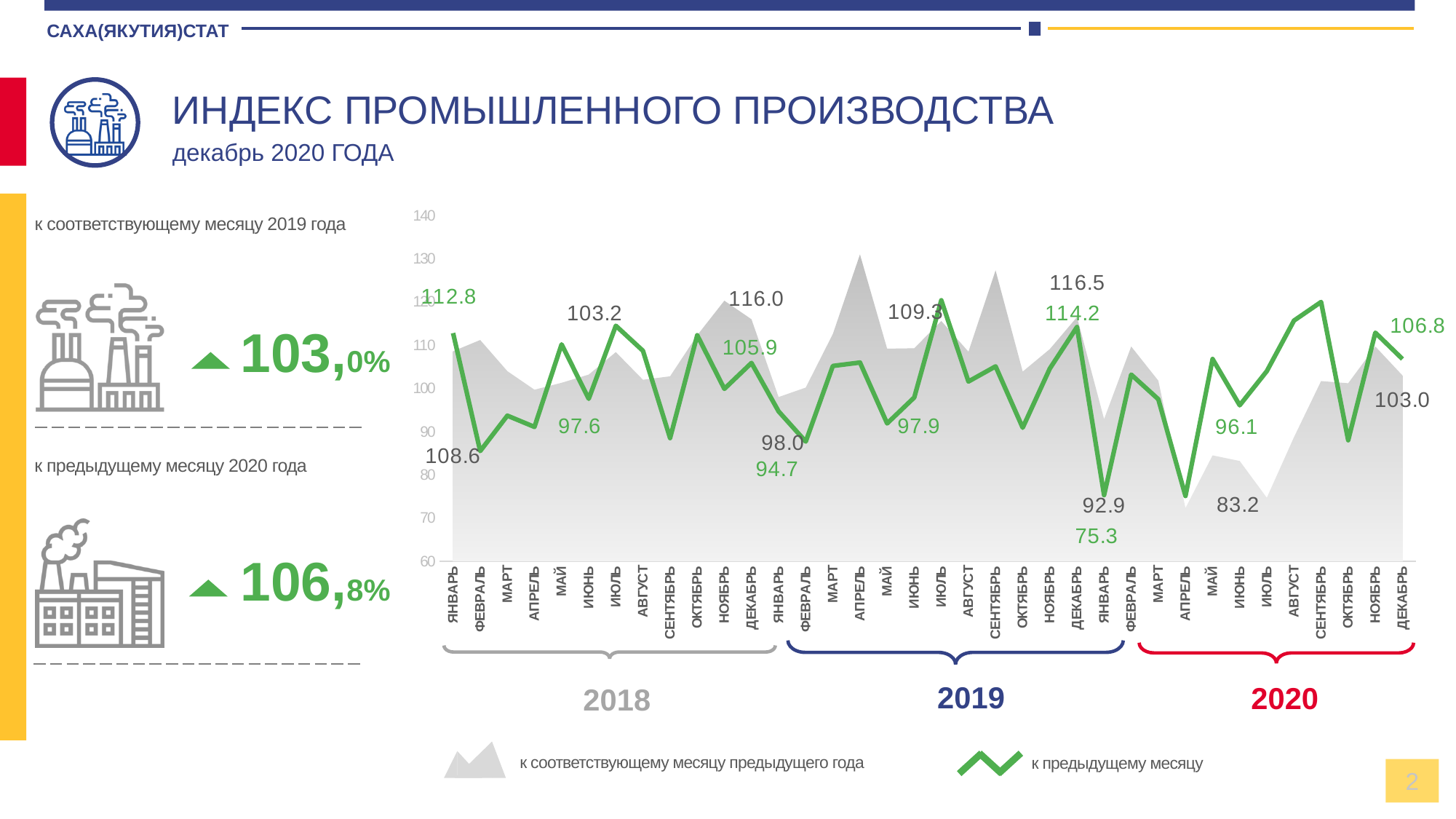
By how much does the green line value for ДЕКАБРЬ 2020 exceed its value for ЯНВАРЬ 2020? 31.5 What is the value of the green line (к предыдущему месяцу) for ДЕКАБРЬ 2020? 106.8 What does the legend say the green line represents? к предыдущему месяцу What kind of chart is shown on the slide? line chart with a shaded area series For ЯНВАРЬ 2018, which series has the larger value: the green line or the grey area? the green line (112.8) What is the difference between the grey area values for ДЕКАБРЬ 2019 (116.5) and ДЕКАБРЬ 2018 (116.0)? 0.5 Is the green line value for АПРЕЛЬ 2020 greater or less than 80? less What is the value of the grey area series (к соответствующему месяцу предыдущего года) for ДЕКАБРЬ 2020? 103.0 What is the value of the green line for ЯНВАРЬ 2020? 75.3 What is the value of the grey area series for ИЮНЬ 2020? 83.2 How many series does the chart legend list? 2 Among the labelled values of the grey area series, which month has the lowest value? ИЮНЬ 2020 (83.2)